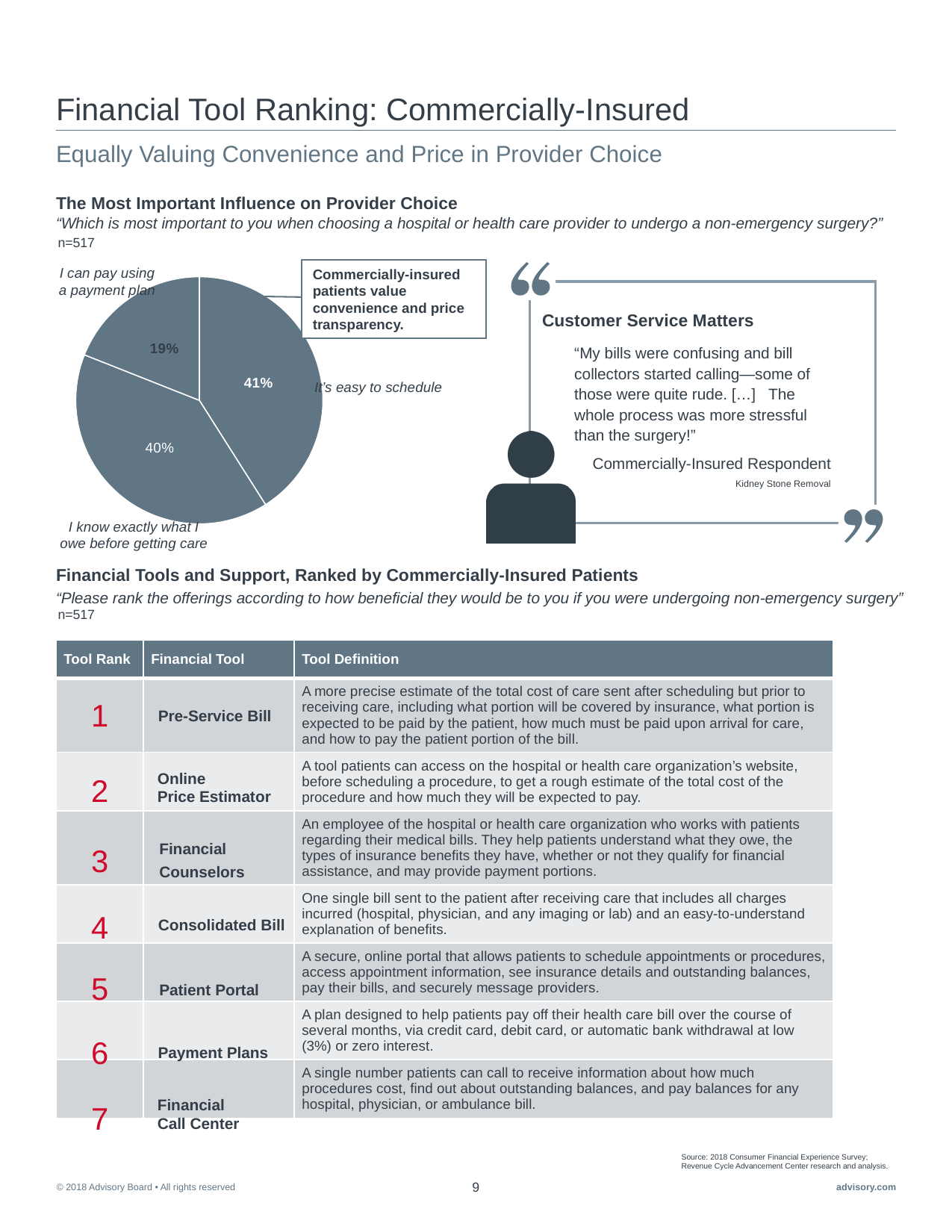
What is the sample size (n) shown for the pie chart on provider choice? n=517 How many slices does the pie chart have? 3 What share of respondents said "I know exactly what I owe before getting care" is most important? 40% What is the title of the pie chart section on the slide? The Most Important Influence on Provider Choice What share of respondents said "I can pay using a payment plan" is most important? 19% Which slice of the pie chart is the largest? It's easy to schedule Which slice of the pie chart is the smallest? I can pay using a payment plan What kind of chart is used to show the most important influence on provider choice? pie chart What share of respondents said "It's easy to schedule" is most important when choosing a provider? 41% Which is larger: the share for "I know exactly what I owe before getting care" or the share for "I can pay using a payment plan"? I know exactly what I owe before getting care What is the difference in percentage points between "I know exactly what I owe before getting care" and "I can pay using a payment plan"? 21 What is the difference in percentage points between "It's easy to schedule" and "I can pay using a payment plan"? 22